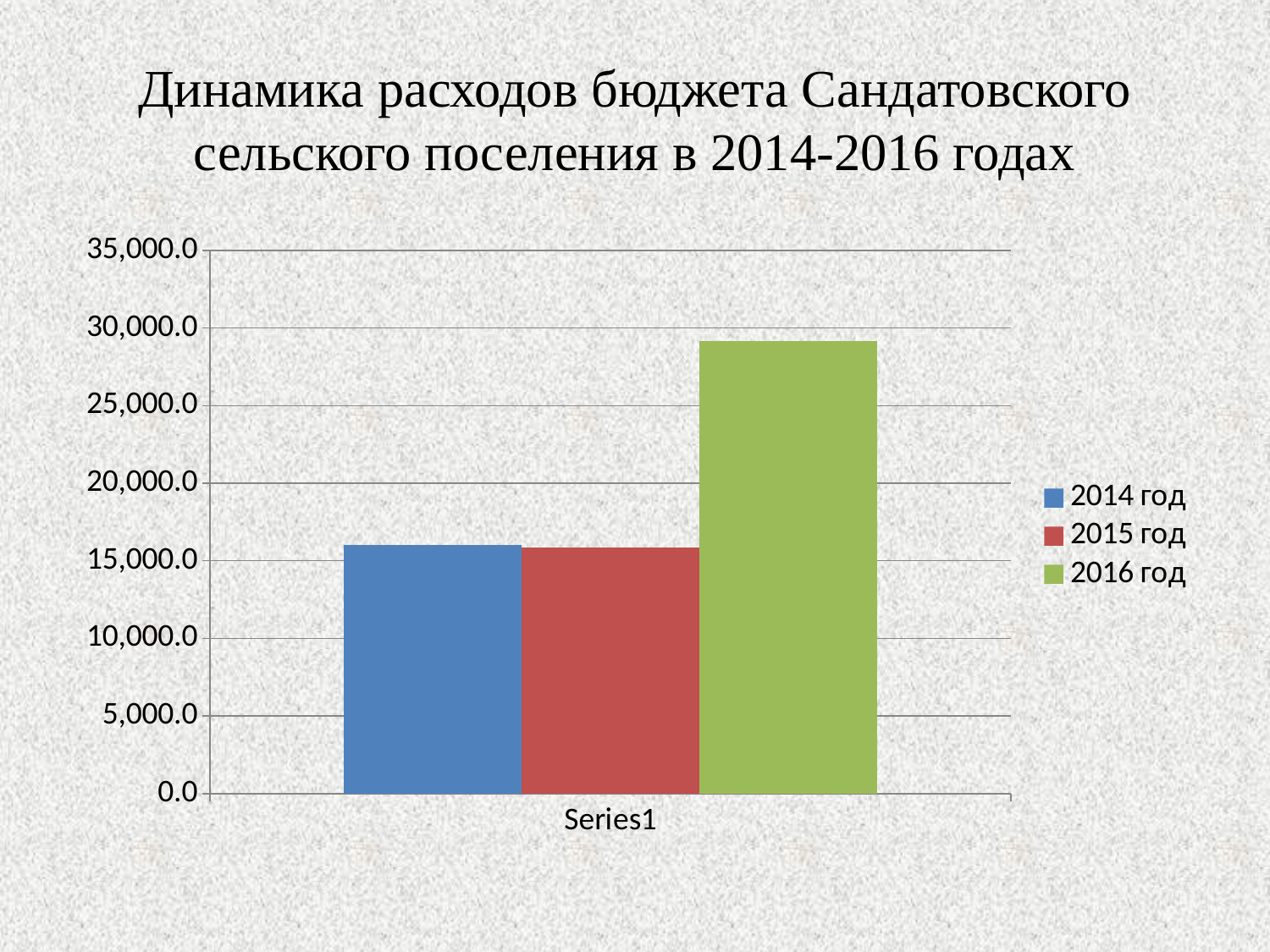
Is the value for 2016 год greater or less than 25,000.0? greater Is the value for 2014 год greater or less than 15,000.0? greater What colour is the bar for 2016 год? green What is the title of the chart? Динамика расходов бюджета Сандатовского сельского поселения в 2014-2016 годах Is the value for 2014 год greater or less than 20,000.0? less How many series does the legend list? 3 Which is larger, the value for 2015 год or the value for 2016 год? 2016 год Which is larger, the value for 2016 год or the value for 2014 год? 2016 год Which year has the highest budget expenditure in the chart? 2016 год What kind of chart is shown on the slide? bar chart